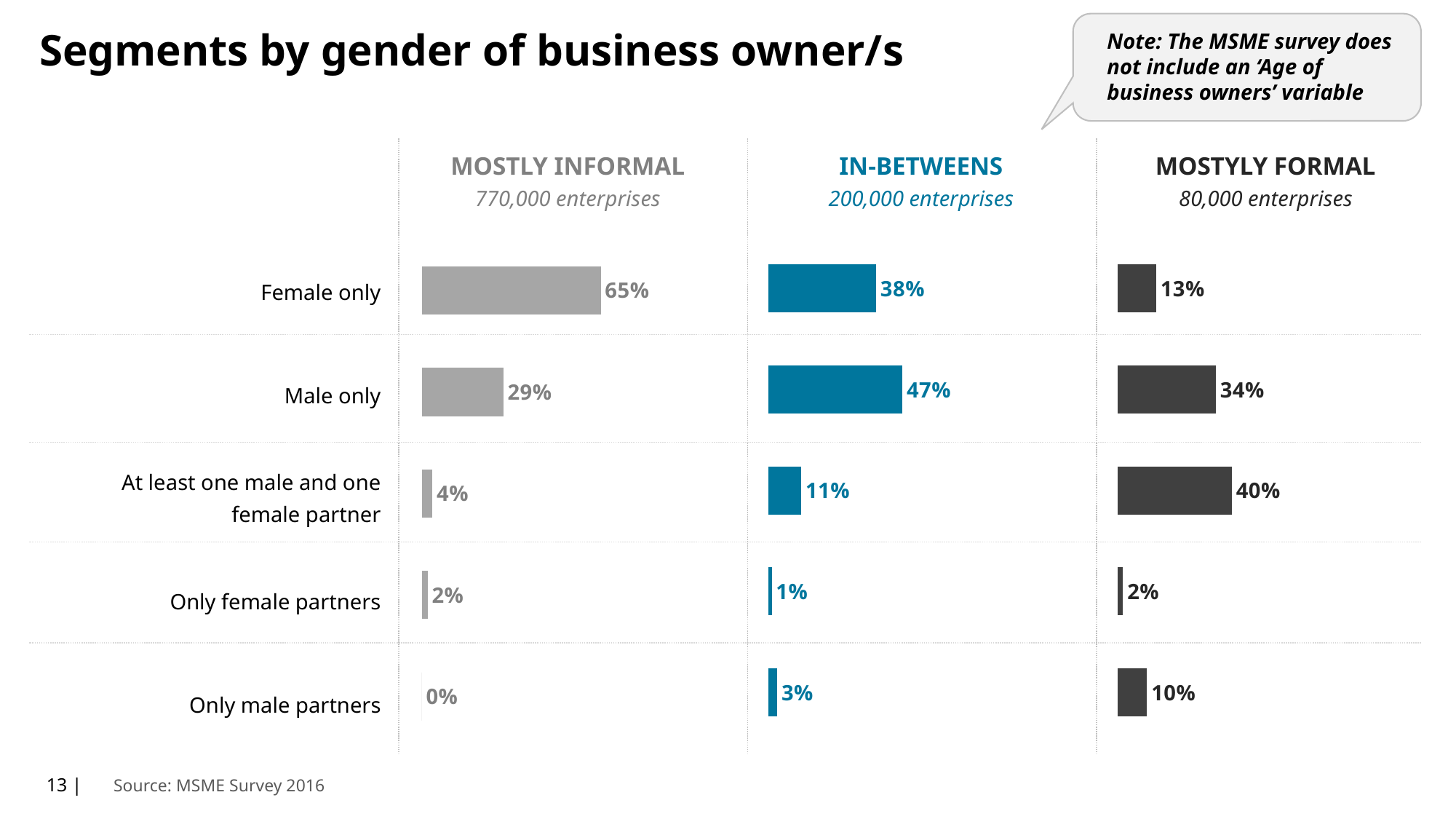
In the Mostly Formal chart, which category has the highest value? At least one male and one female partner What kind of chart is used on this slide? Bar chart Which is larger: Female only in the In-Betweens chart or Female only in the Mostly Formal chart? In-Betweens In the In-Betweens chart, what is the value for Male only? 47% In the Mostly Formal chart, what is the difference between Male only and Female only? 21% In the Mostly Informal chart, which category has the lowest value? Only male partners In the Mostly Informal chart, what is the difference between Female only and Male only? 36% How many enterprises does the In-Betweens segment represent? 200,000 enterprises How many categories are shown in each chart? 5 In the In-Betweens chart, which category has the highest value? Male only In the Mostly Informal chart, what is the value for Female only? 65% In the Mostly Formal chart, what is the value for At least one male and one female partner? 40%